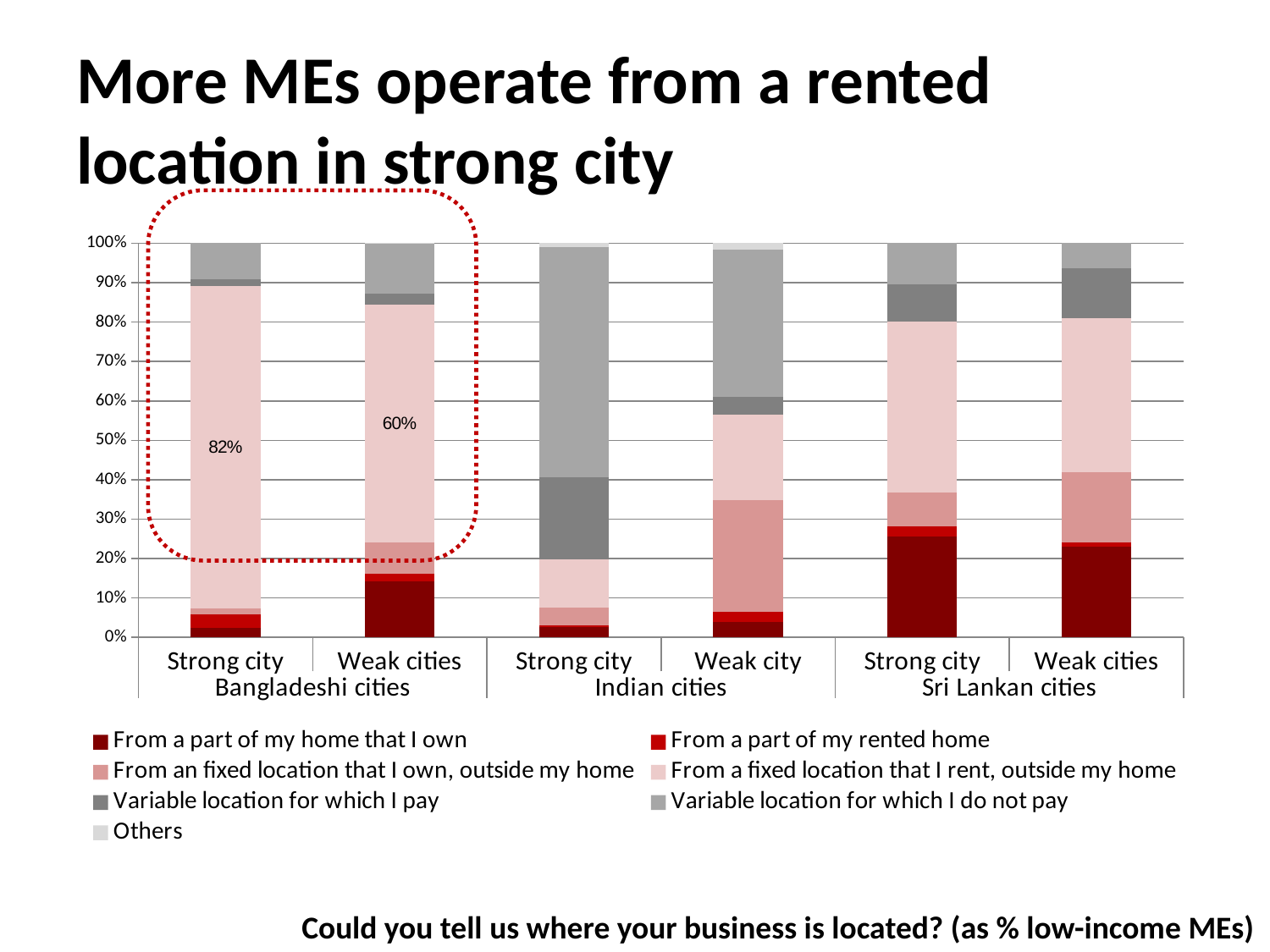
Is the 'Variable location for which I do not pay' segment for the Indian Strong city bar greater or less than 50%? greater In the Bangladeshi Weak cities bar, what percentage is shown for 'From a fixed location that I rent, outside my home'? 60% Which legend entry is shown in the darkest red colour? From a part of my home that I own What kind of chart is shown on the slide? Stacked bar chart How many series does the legend list? 7 Which Bangladeshi bar has the larger labelled share for 'From a fixed location that I rent, outside my home': Strong city or Weak cities? Strong city What is the difference between the labelled 'From a fixed location that I rent, outside my home' values for the Bangladeshi Strong city and Weak cities bars? 22 percentage points What is the title of the slide? More MEs operate from a rented location in strong city In the Bangladeshi Strong city bar, what percentage is shown for 'From a fixed location that I rent, outside my home'? 82% Is the 'From a part of my home that I own' segment for the Bangladeshi Strong city bar greater or less than 10%? less How many bars are plotted in the chart? 6 Is the 'From a part of my home that I own' segment for the Sri Lankan Strong city bar greater or less than 20%? greater